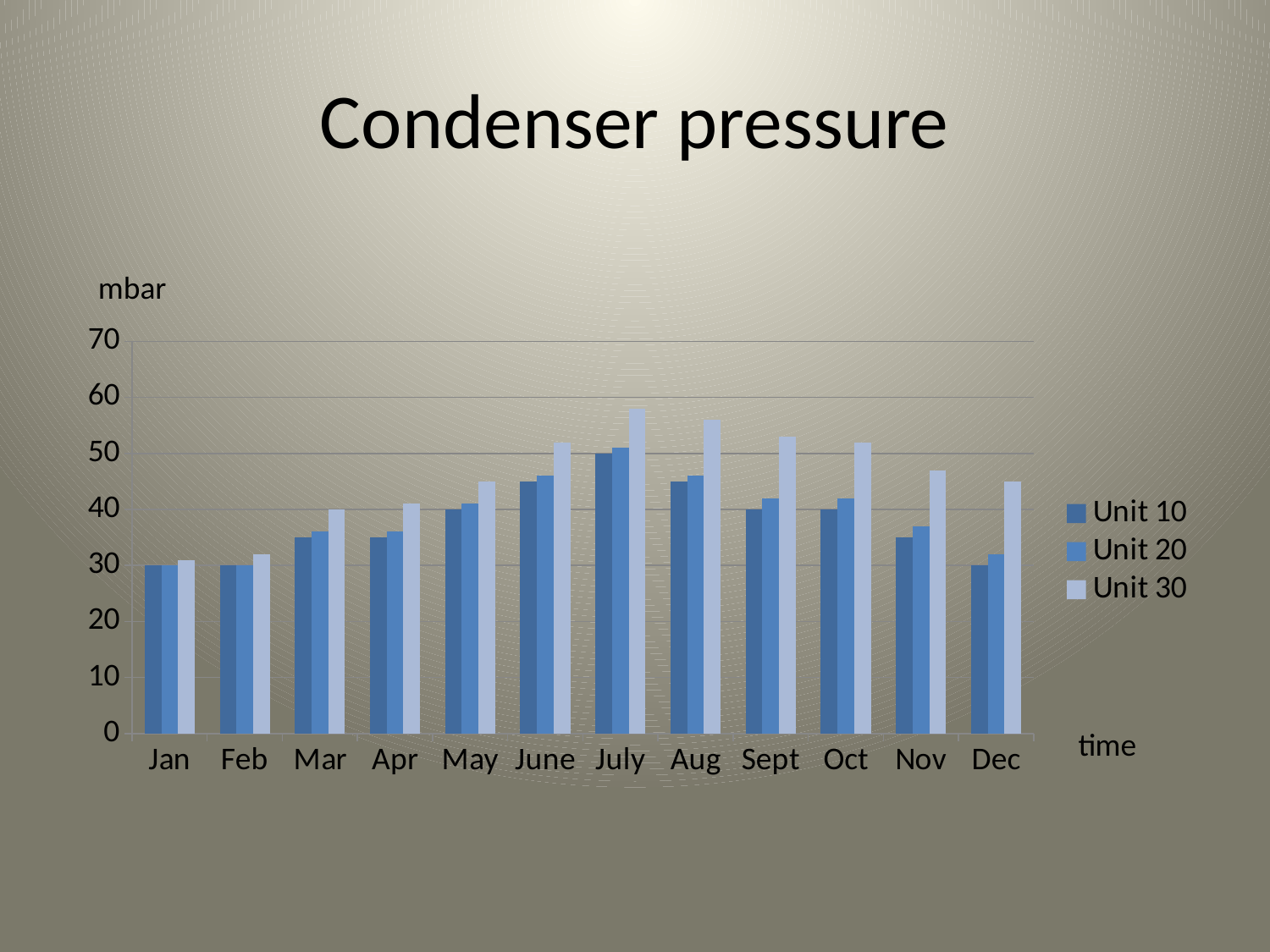
Which series has the tallest bar in July? Unit 30 What is the title of the chart? Condenser pressure In which month does Unit 10 reach its highest value? July Is the value for Unit 30 in July greater or less than 50? greater How many months are shown along the x axis? 12 What kind of chart is shown on the slide? bar chart Is the value for Unit 10 in Jan greater or less than 40? less Is the value for Unit 30 in Nov greater or less than 40? greater What unit is shown on the vertical axis label? mbar In Aug, which is larger: Unit 10 or Unit 30? Unit 30 Do the Unit 10 values rise or fall from Jan to July? rise How many series does the legend list? 3